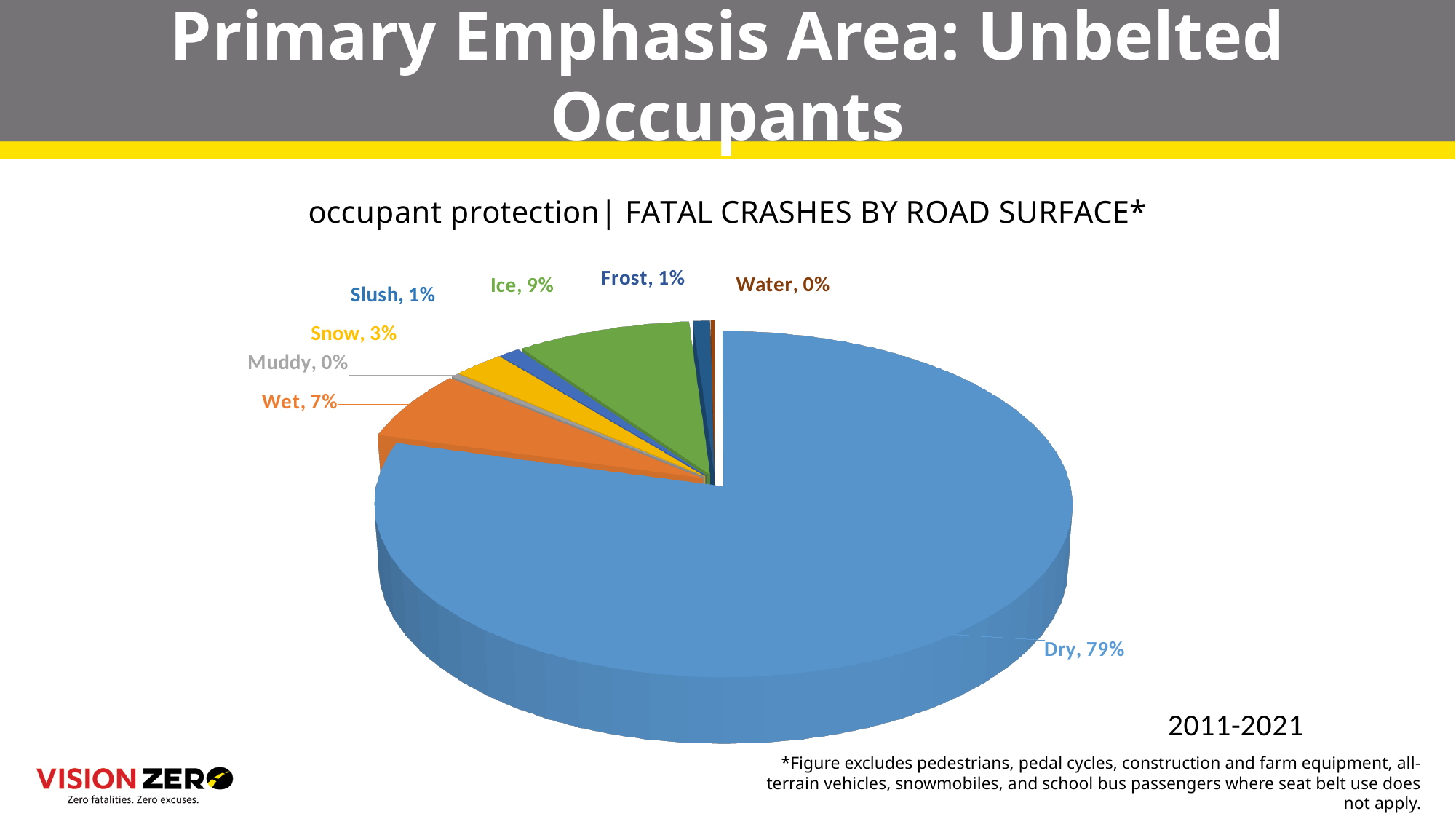
Which road surface category has the largest share of fatal crashes? Dry What share of fatal crashes occurred on a snowy road surface? 3% What time period does the chart cover? 2011-2021 What share of fatal crashes occurred on a wet road surface? 7% How many road surface categories are shown in the pie chart? 8 Which two road surface categories are labelled with 0%? Muddy and Water What kind of chart is shown on the slide? Pie chart What share of fatal crashes occurred on a dry road surface? 79% Which has a larger share of fatal crashes, Ice or Wet? Ice What is the difference in percentage points between the Wet and Snow shares? 4 What share of fatal crashes occurred on an icy road surface? 9% What is the difference in percentage points between the Dry and Ice shares? 70